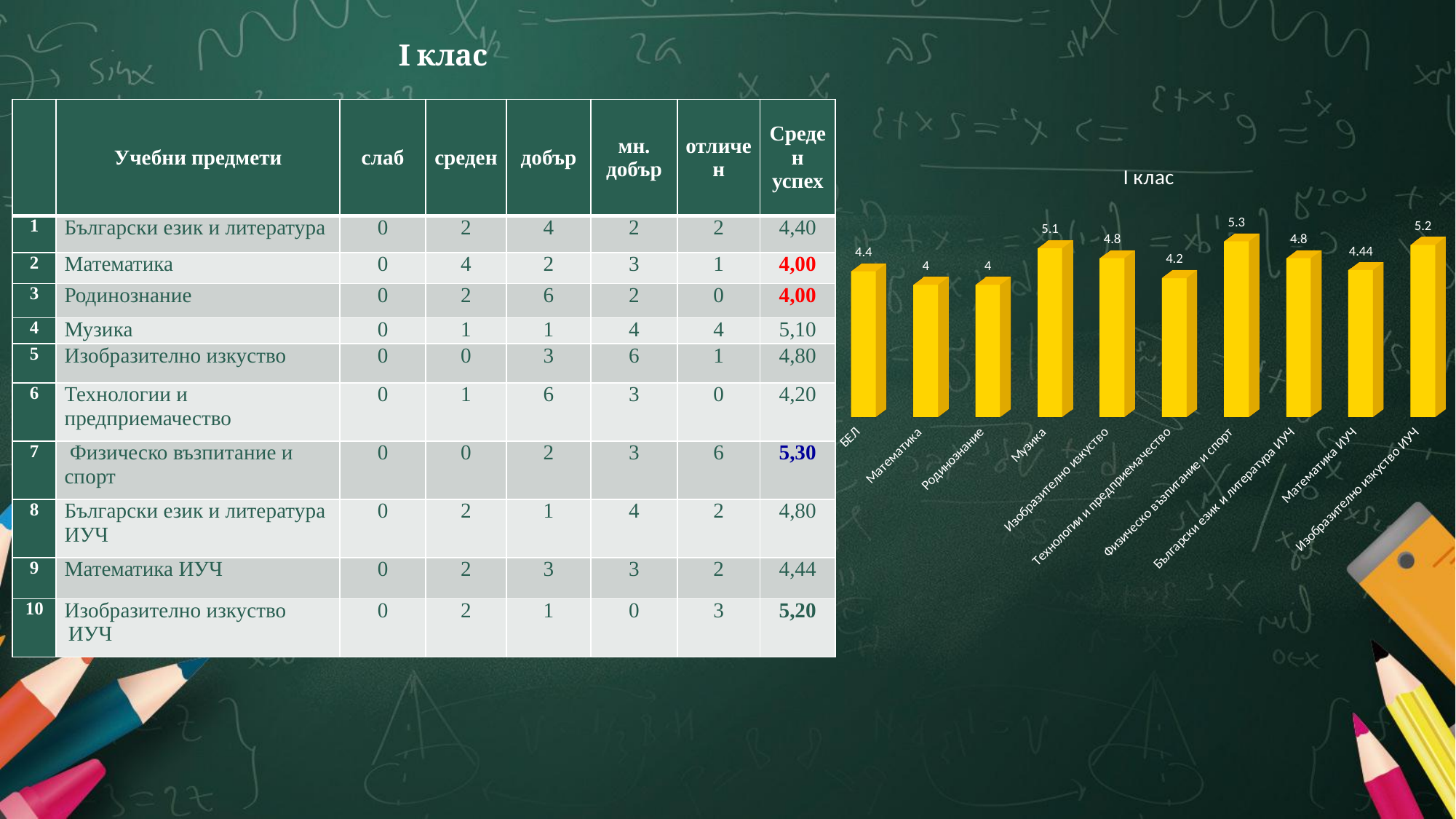
What is the value for Музика in the chart? 5.1 Which is larger in the chart: the value for БЕЛ or the value for Изобразително изкуство? Изобразително изкуство What is the value for Родинознание in the chart? 4 What is the value for Технологии и предприемачество in the chart? 4.2 What colour are the bars in the chart? yellow What is the value for Математика ИУЧ in the chart? 4.44 What is the difference between the values for Физическо възпитание и спорт and Математика in the chart? 1.3 How many categories (bars) does the chart show? 10 What is the difference between the values for Изобразително изкуство ИУЧ and Музика in the chart? 0.1 Which category has the highest value in the chart? Физическо възпитание и спорт What is the title of the chart? I клас What kind of chart is shown on the slide? bar chart